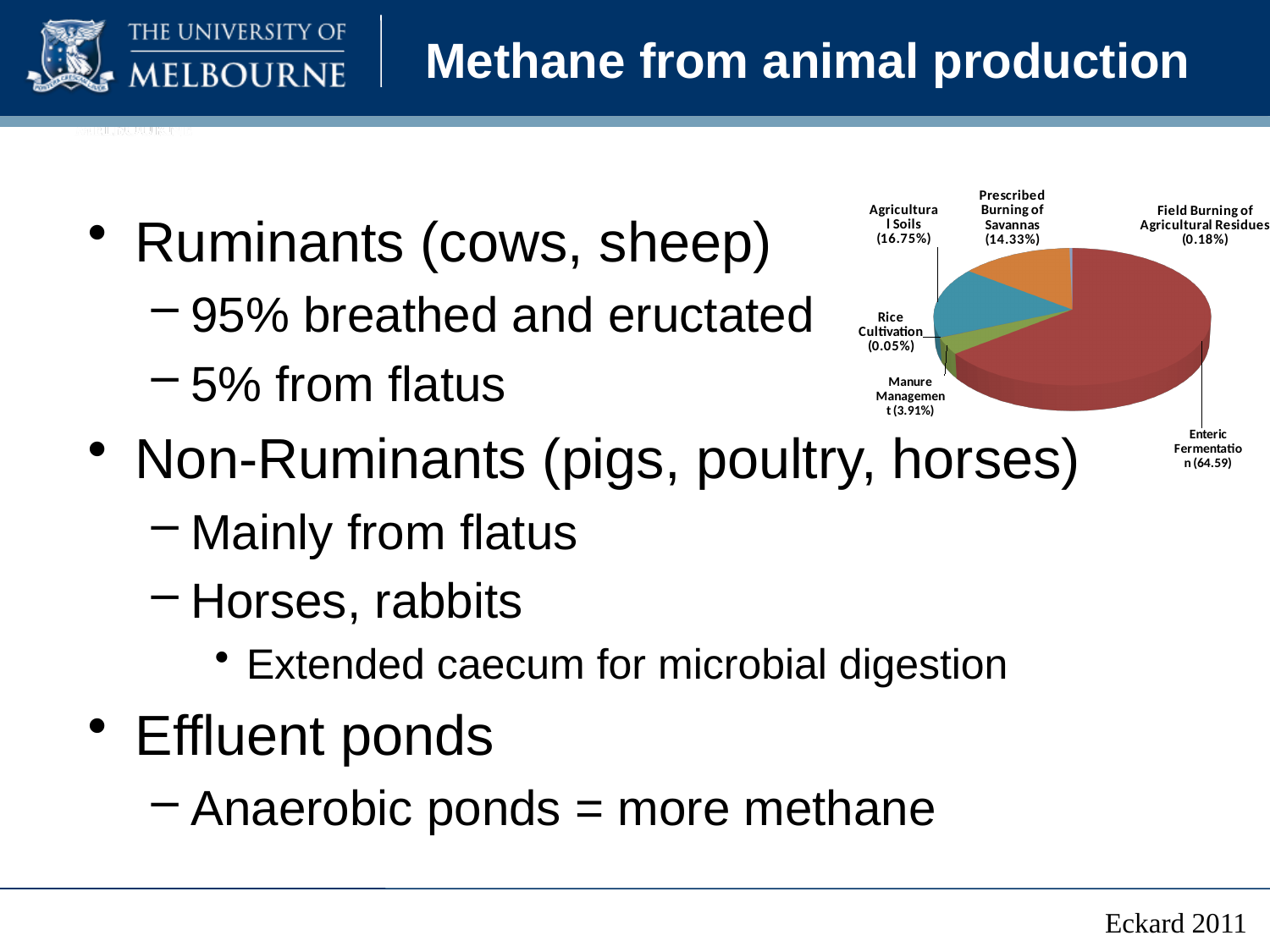
Which is larger, the share for Manure Management or the share for Field Burning of Agricultural Residues? Manure Management What kind of chart is shown on the slide? pie chart What share of the pie is Agricultural Soils? 16.75% What share of the pie is Field Burning of Agricultural Residues? 0.18% Which category has the smallest slice of the pie? Rice Cultivation What share of the pie is Manure Management? 3.91% What colour is the Enteric Fermentation slice of the pie? red Which category has the largest slice of the pie? Enteric Fermentation How many slices does the pie chart have? 6 What is the difference between the shares of Agricultural Soils and Prescribed Burning of Savannas? 2.42%